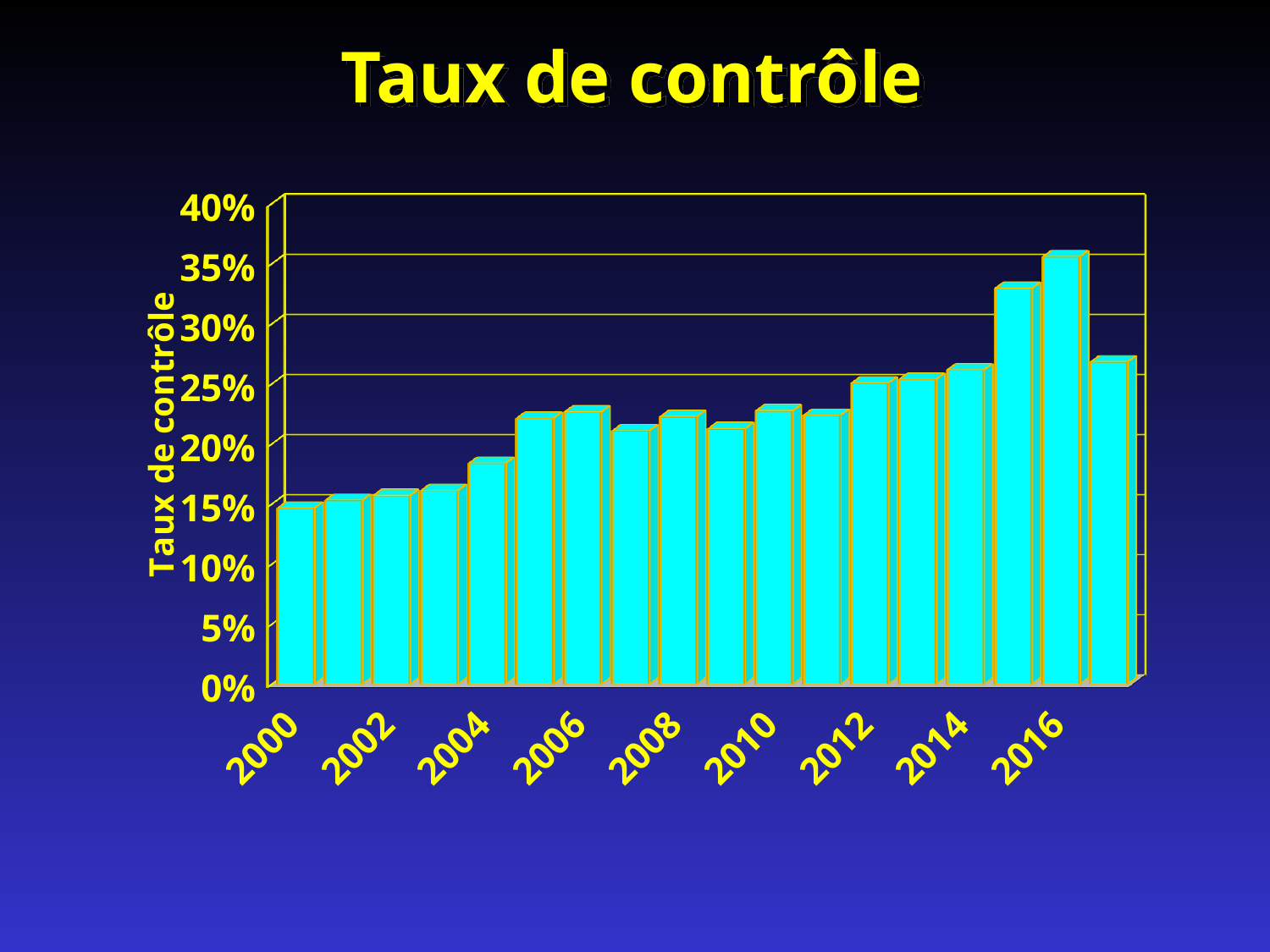
Is the value for 2016 greater or less than 30%? greater Is the value for 2008 greater or less than 25%? less Which year has the lowest control rate? 2000 Which year has the larger value, 2002 or 2006? 2006 What kind of chart is shown on the slide? bar chart Is the value for 2000 greater or less than 20%? less Do the values generally rise or fall from 2000 to 2016? rise Which year has the larger value, 2014 or 2016? 2016 Which year has the highest control rate? 2016 What is the title of the chart? Taux de contrôle What is the label on the vertical axis? Taux de contrôle